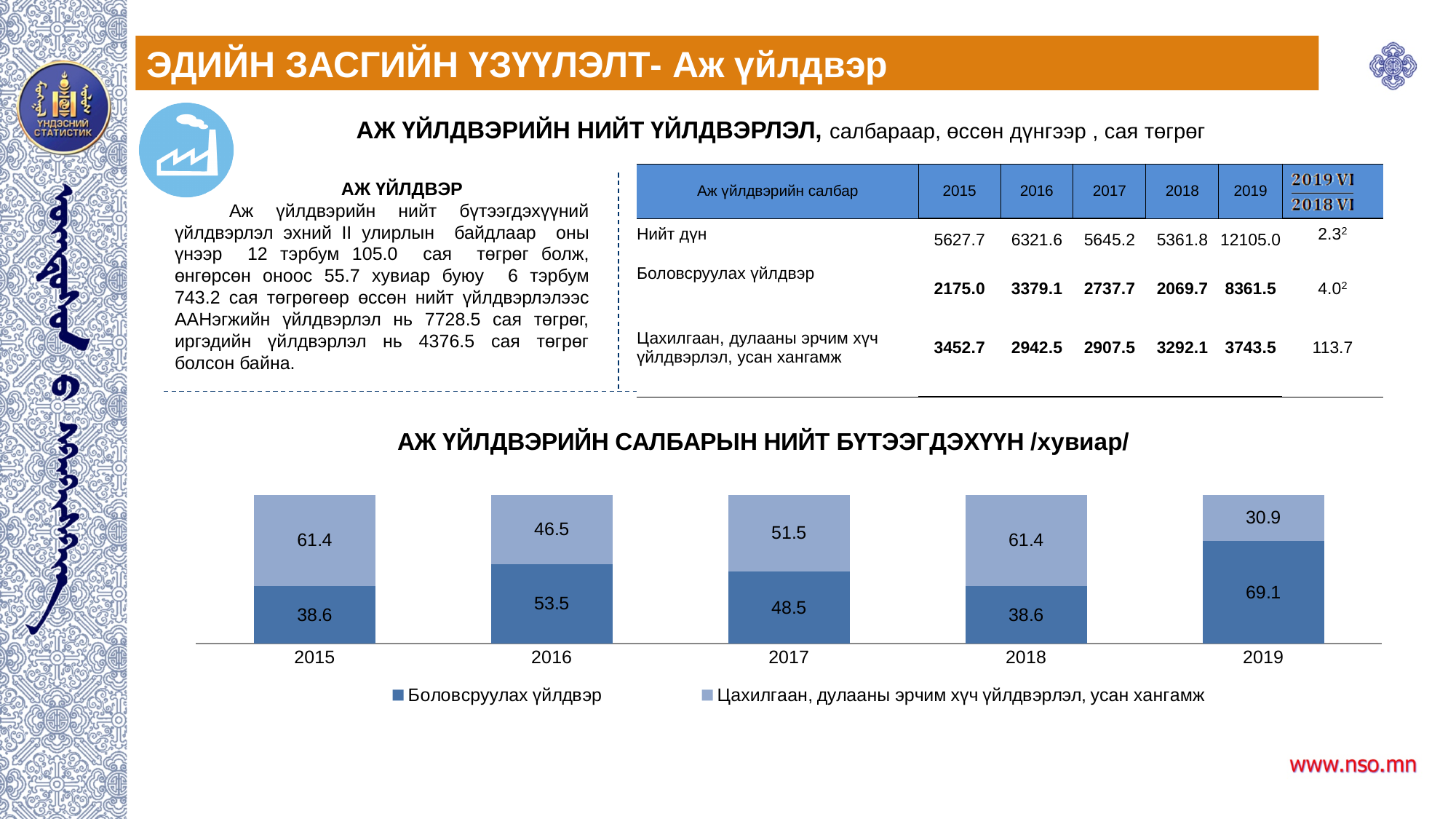
How many series does the chart legend list? 2 What is the difference between the Боловсруулах үйлдвэр values for 2019 and 2018? 30.5 What is the value for Цахилгаан, дулааны эрчим хүч үйлдвэрлэл, усан хангамж in 2016? 46.5 What kind of chart is shown on the slide? stacked bar chart How many years are shown on the x axis of the chart? 5 What is the value for Боловсруулах үйлдвэр in 2019? 69.1 In which year is the value for Цахилгаан, дулааны эрчим хүч үйлдвэрлэл, усан хангамж lowest? 2019 What is the total of the stacked bar for 2016? 100 In which year is the value for Боловсруулах үйлдвэр highest? 2019 What is the title of the chart? АЖ ҮЙЛДВЭРИЙН САЛБАРЫН НИЙТ БҮТЭЭГДЭХҮҮН /хувиар/ What is the value for Боловсруулах үйлдвэр in 2017? 48.5 Which is larger in 2017: Боловсруулах үйлдвэр or Цахилгаан, дулааны эрчим хүч үйлдвэрлэл, усан хангамж? Цахилгаан, дулааны эрчим хүч үйлдвэрлэл, усан хангамж